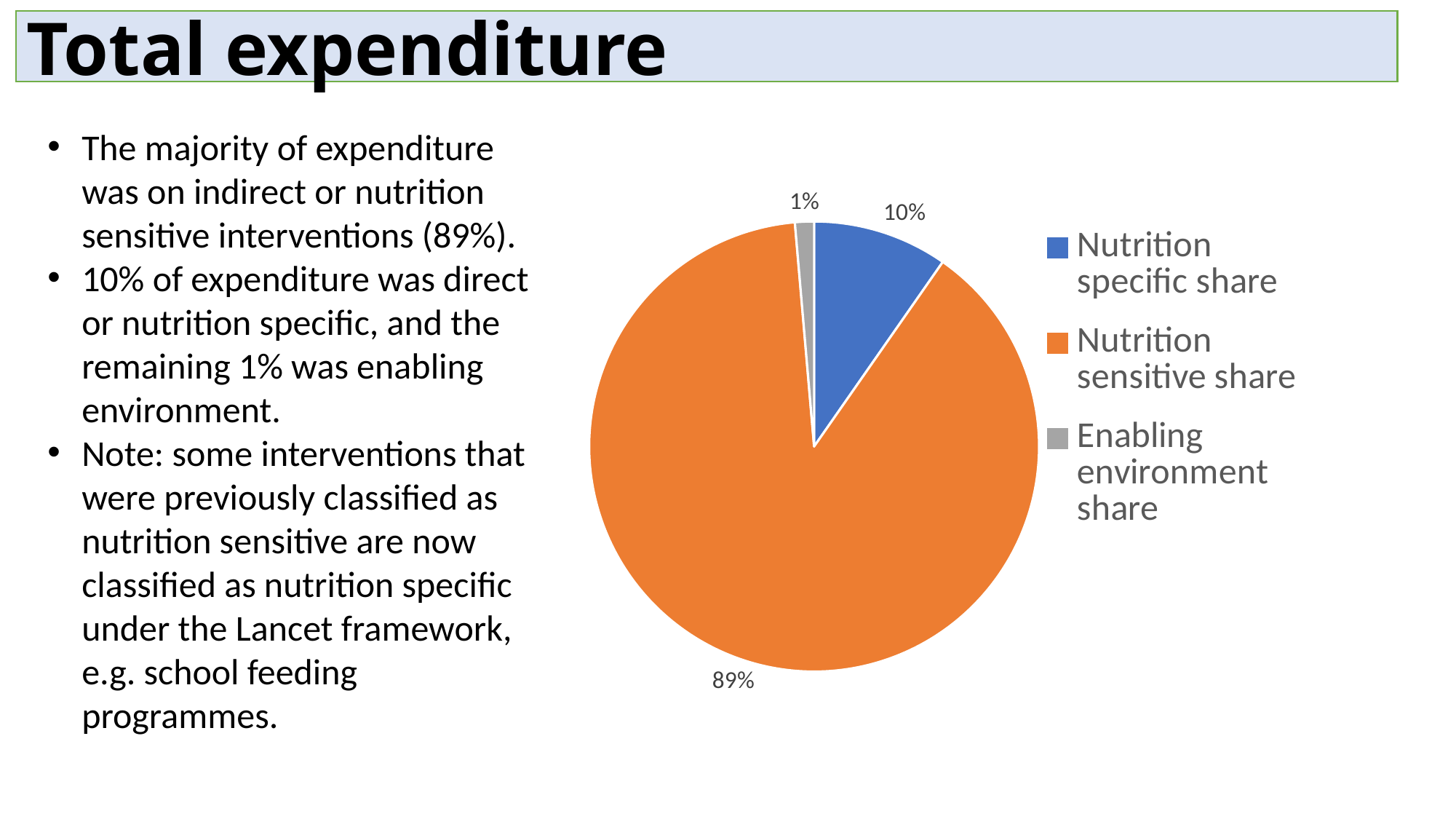
What colour is the Nutrition sensitive share slice? orange What share of the pie is Nutrition specific share? 10% What share of the pie is Nutrition sensitive share? 89% Which is larger, Nutrition specific share or Enabling environment share? Nutrition specific share What share of the pie is Enabling environment share? 1% What kind of chart is shown on the slide? pie chart Which category has the smallest slice of the pie? Enabling environment share Which category has the largest slice of the pie? Nutrition sensitive share How many slices does the pie chart have? 3 How many entries does the legend list? 3 What is the difference in percentage points between Nutrition sensitive share and Nutrition specific share? 79 What colour is the Nutrition specific share slice? blue